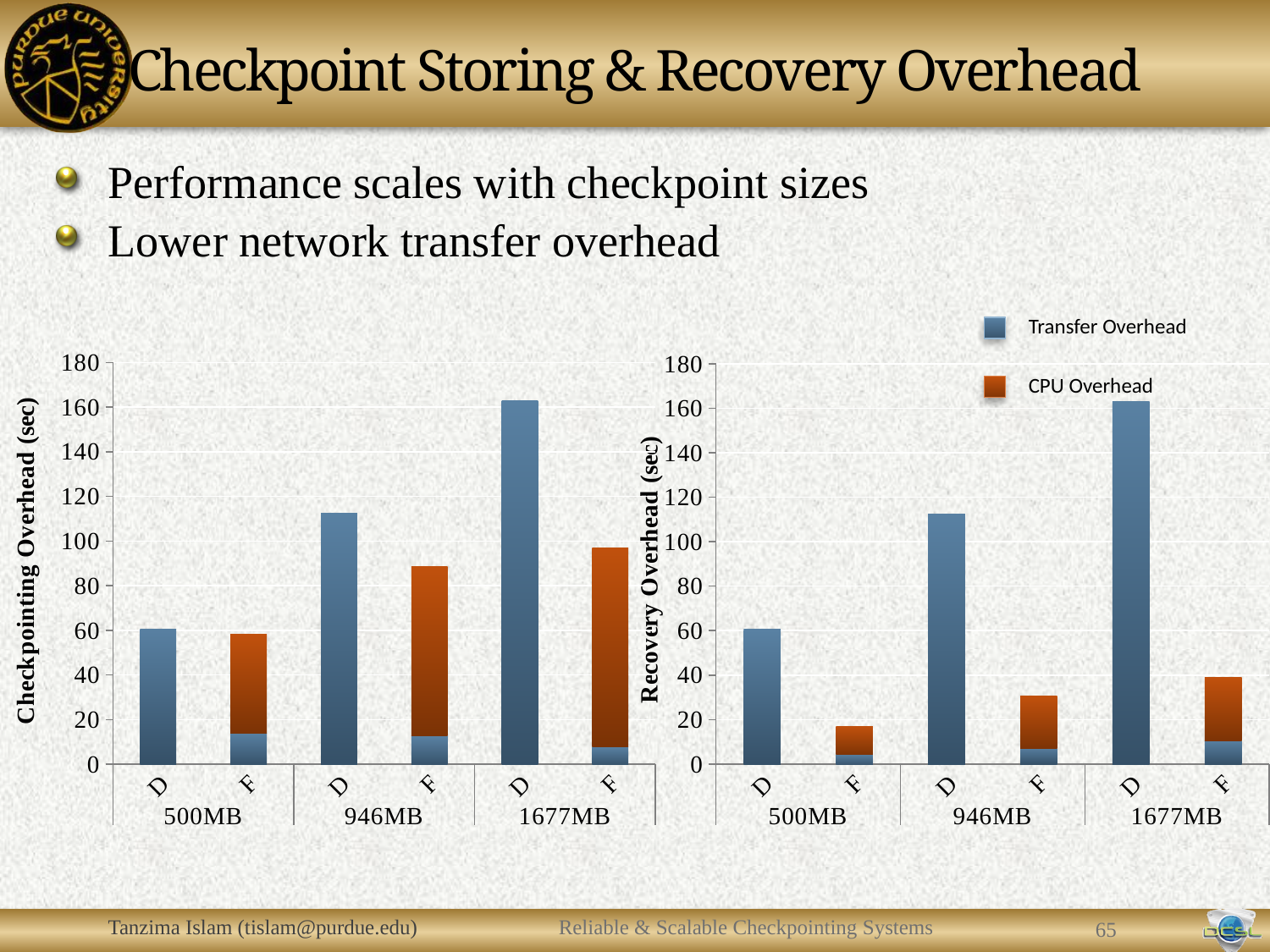
What kind of chart is the left chart, Checkpointing Overhead (sec)? bar chart In the left chart, Checkpointing Overhead (sec), is the value of the D bar at 1677MB greater or less than 140? greater In the left chart, Checkpointing Overhead (sec), is the value of the D bar at 500MB greater or less than 80? less In the right chart, Recovery Overhead (sec), is the value of the D bar at 946MB greater or less than 100? greater In the left chart, Checkpointing Overhead (sec), which checkpoint size has the tallest D bar? 1677MB What are the two series named in the legend? Transfer Overhead and CPU Overhead How many checkpoint size groups are shown on the x axis of the right chart, Recovery Overhead (sec)? 3 How many series does the legend list? 2 In the right chart, Recovery Overhead (sec), which is larger at 1677MB, the D bar or the F bar? D In the left chart, Checkpointing Overhead (sec), do the D bars rise or fall as the checkpoint size increases from 500MB to 1677MB? rise